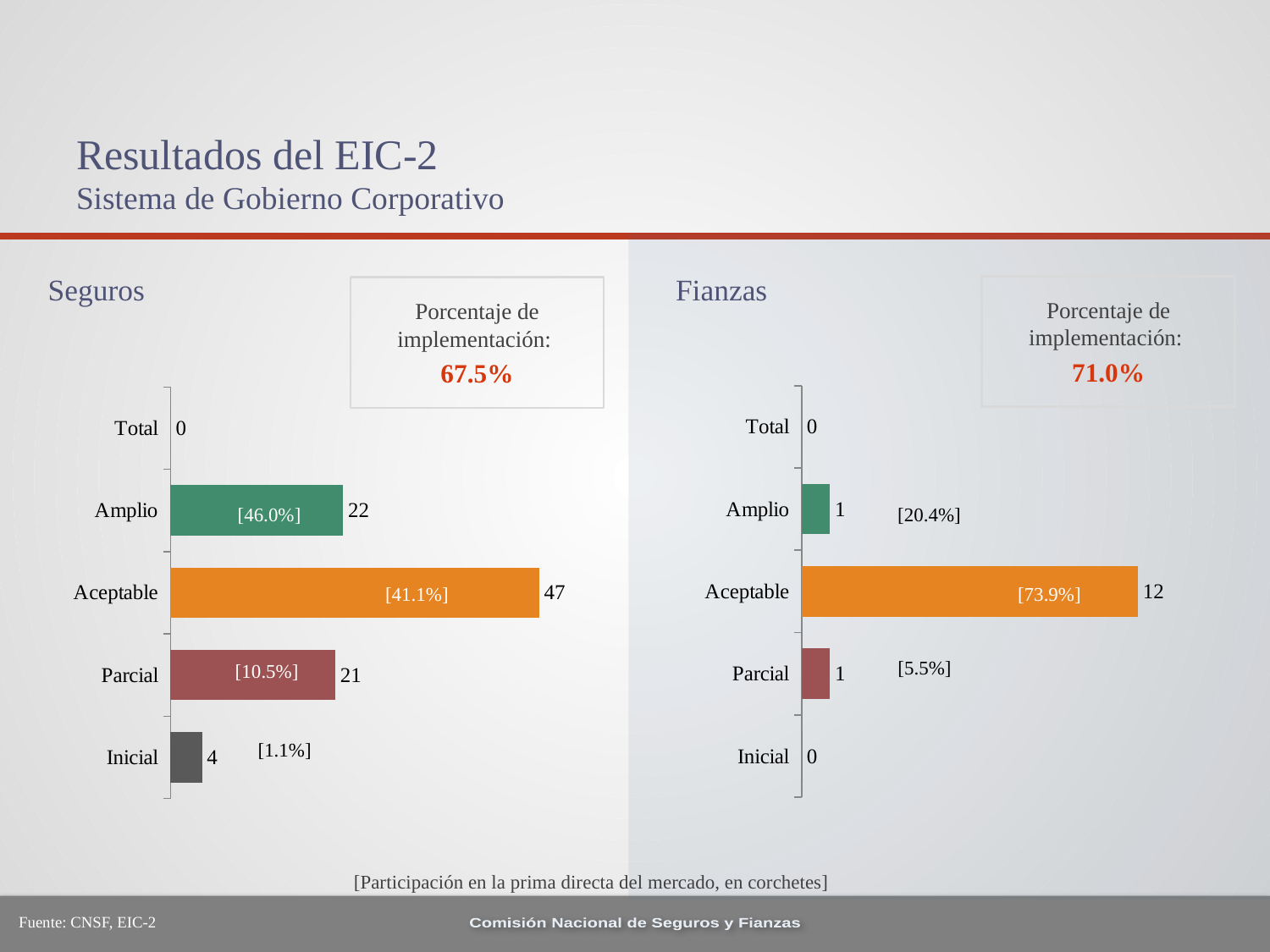
How many categories are shown in the Fianzas chart? 5 In the Seguros chart, which category has the highest value? Aceptable In the Seguros chart, what is the difference between the values for Aceptable and Amplio? 25 What percentage of implementation is shown in the box next to the Fianzas chart? 71.0% In the Fianzas chart, what market share in brackets is shown for Parcial? [5.5%] What kind of chart is the Seguros chart? Bar chart In the Seguros chart, what is the value for Aceptable? 47 In the Seguros chart, what market share in brackets is shown for Amplio? [46.0%] In the Fianzas chart, what is the value for Aceptable? 12 In the Seguros chart, which is larger, the value for Amplio or the value for Parcial? Amplio In the Seguros chart, what is the value for Inicial? 4 In the Fianzas chart, which category has the highest value? Aceptable